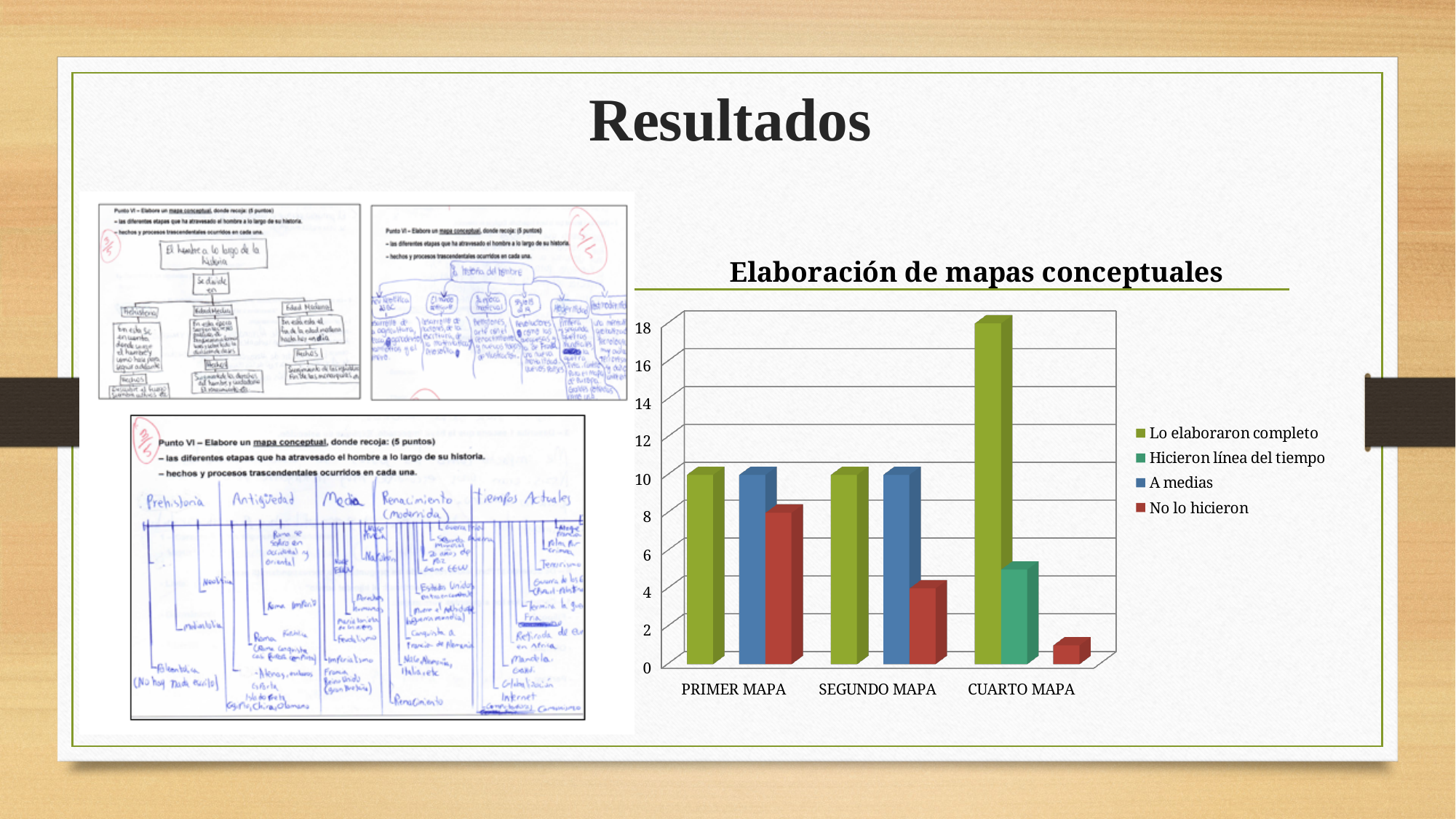
Do the 'No lo hicieron' values rise or fall from PRIMER MAPA to CUARTO MAPA in the 'Elaboración de mapas conceptuales' chart? fall How many series does the legend of the 'Elaboración de mapas conceptuales' chart list? 4 In the 'Elaboración de mapas conceptuales' chart, is the 'No lo hicieron' value for PRIMER MAPA greater or less than 6? greater How many categories are shown on the x axis of the 'Elaboración de mapas conceptuales' chart? 3 In the 'Elaboración de mapas conceptuales' chart, is the 'Lo elaboraron completo' value for CUARTO MAPA greater or less than 16? greater What kind of chart is 'Elaboración de mapas conceptuales'? bar chart In the 'Elaboración de mapas conceptuales' chart, which category has the highest 'Lo elaboraron completo' bar? CUARTO MAPA In the 'Elaboración de mapas conceptuales' chart, which category is the only one with a 'Hicieron línea del tiempo' bar? CUARTO MAPA In the 'Elaboración de mapas conceptuales' chart, which category has the lowest 'No lo hicieron' bar? CUARTO MAPA In the 'Elaboración de mapas conceptuales' chart, is the 'No lo hicieron' value for CUARTO MAPA greater or less than 2? less In the 'Elaboración de mapas conceptuales' chart, which has the larger 'No lo hicieron' value, PRIMER MAPA or SEGUNDO MAPA? PRIMER MAPA What is the title of the chart on the slide? Elaboración de mapas conceptuales